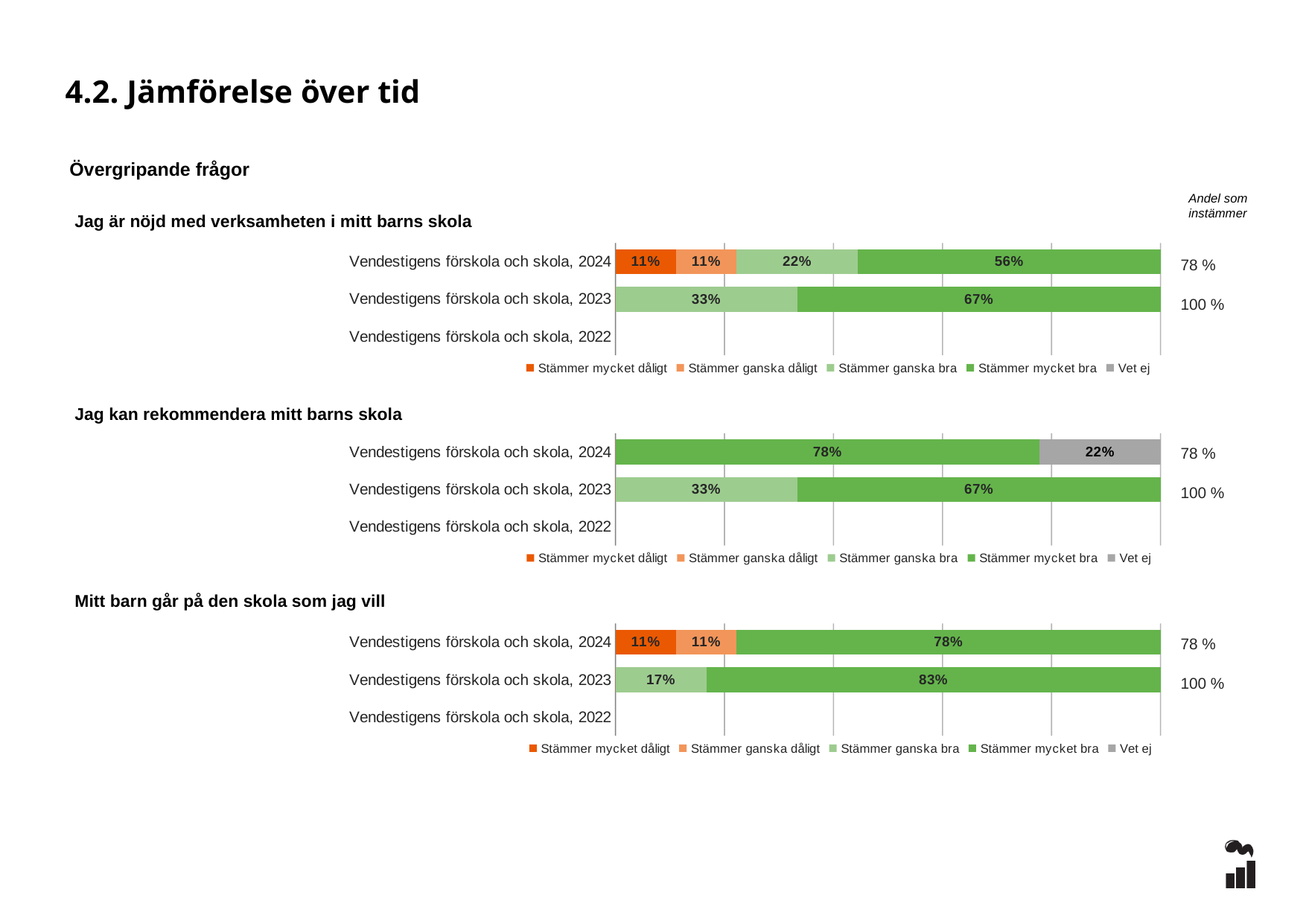
In the chart 'Jag kan rekommendera mitt barns skola', what is the 'Andel som instämmer' value shown for Vendestigens förskola och skola, 2023? 100 % In the chart 'Jag är nöjd med verksamheten i mitt barns skola', what is the value of 'Stämmer ganska bra' for Vendestigens förskola och skola, 2023? 33% What kind of chart is 'Jag är nöjd med verksamheten i mitt barns skola'? Stacked bar chart In the chart 'Jag är nöjd med verksamheten i mitt barns skola', which year has the larger 'Stämmer mycket bra' value, 2023 or 2024? 2023 How many category rows are shown in the chart 'Mitt barn går på den skola som jag vill'? 3 In the chart 'Jag är nöjd med verksamheten i mitt barns skola', what is the value of 'Stämmer mycket bra' for Vendestigens förskola och skola, 2024? 56% In the chart 'Mitt barn går på den skola som jag vill', what is the difference between 'Stämmer mycket bra' for 2023 and for 2024? 5% In the chart 'Jag kan rekommendera mitt barns skola', what is the value of 'Vet ej' for Vendestigens förskola och skola, 2024? 22% In the chart 'Mitt barn går på den skola som jag vill', what is the value of 'Stämmer mycket bra' for Vendestigens förskola och skola, 2023? 83% In the chart 'Jag kan rekommendera mitt barns skola', which segment is the largest in the 2024 bar? Stämmer mycket bra How many series does the legend list in the chart 'Jag kan rekommendera mitt barns skola'? 5 In the chart 'Jag är nöjd med verksamheten i mitt barns skola', what is the total of the 'Stämmer mycket dåligt' and 'Stämmer ganska dåligt' segments for 2024? 22%